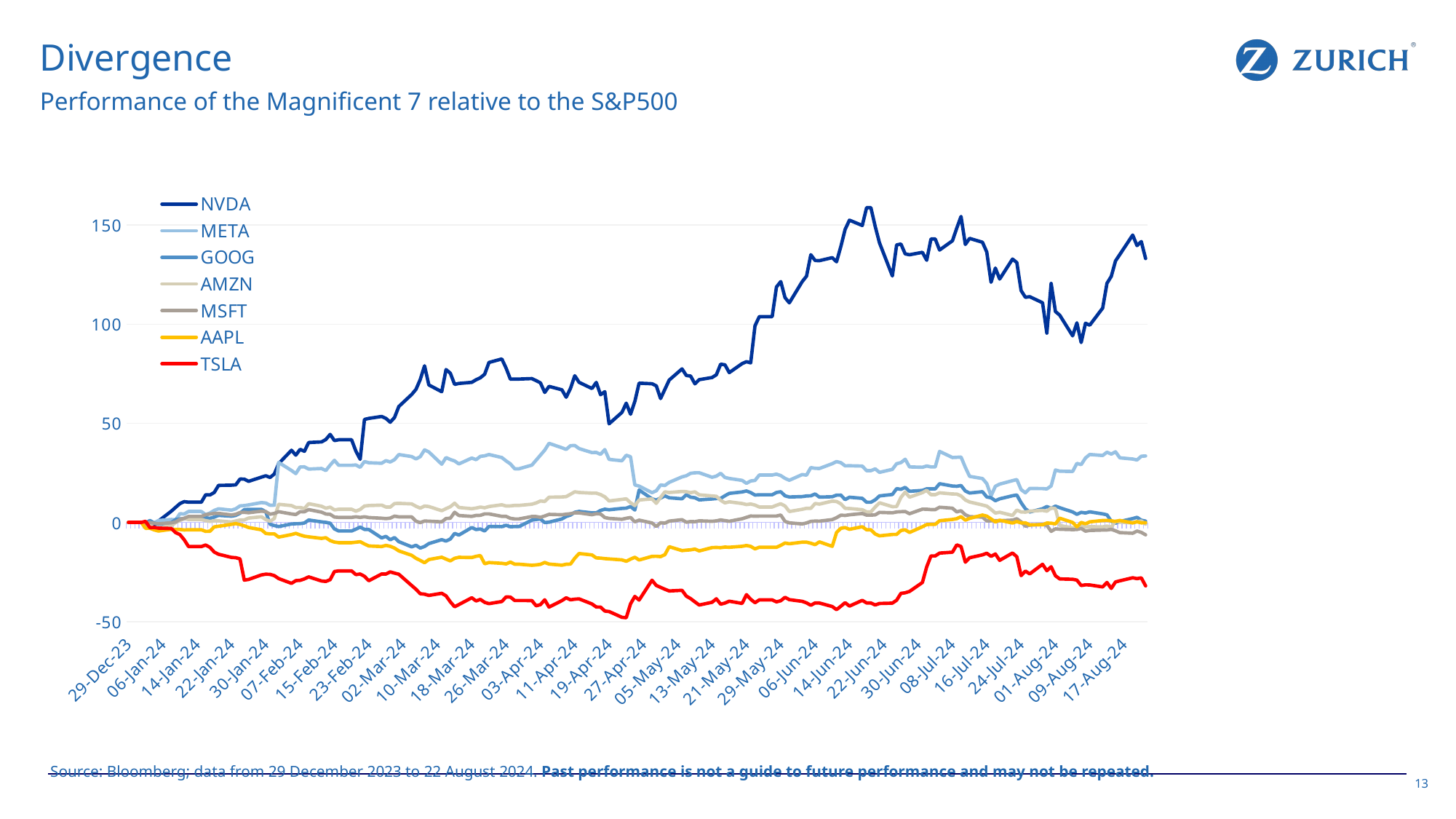
Is the value for TSLA at the end of the period (17-Aug-24) greater or less than 0? less What is the subtitle of the chart on the slide? Performance of the Magnificent 7 relative to the S&P500 How many series does the legend list? 7 Which series has the larger value at the end of the period, NVDA or TSLA? NVDA Does the NVDA line generally rise or fall from 29-Dec-23 to 17-Aug-24? Rise Is the value for META at the end of the period (17-Aug-24) greater or less than 50? less Which series reaches the lowest value on the chart? TSLA What kind of chart is shown on the slide? Line chart Which series is drawn in red in the legend? TSLA Is the value for NVDA at the end of the period (17-Aug-24) greater or less than 100? greater Which series reaches the highest value on the chart? NVDA